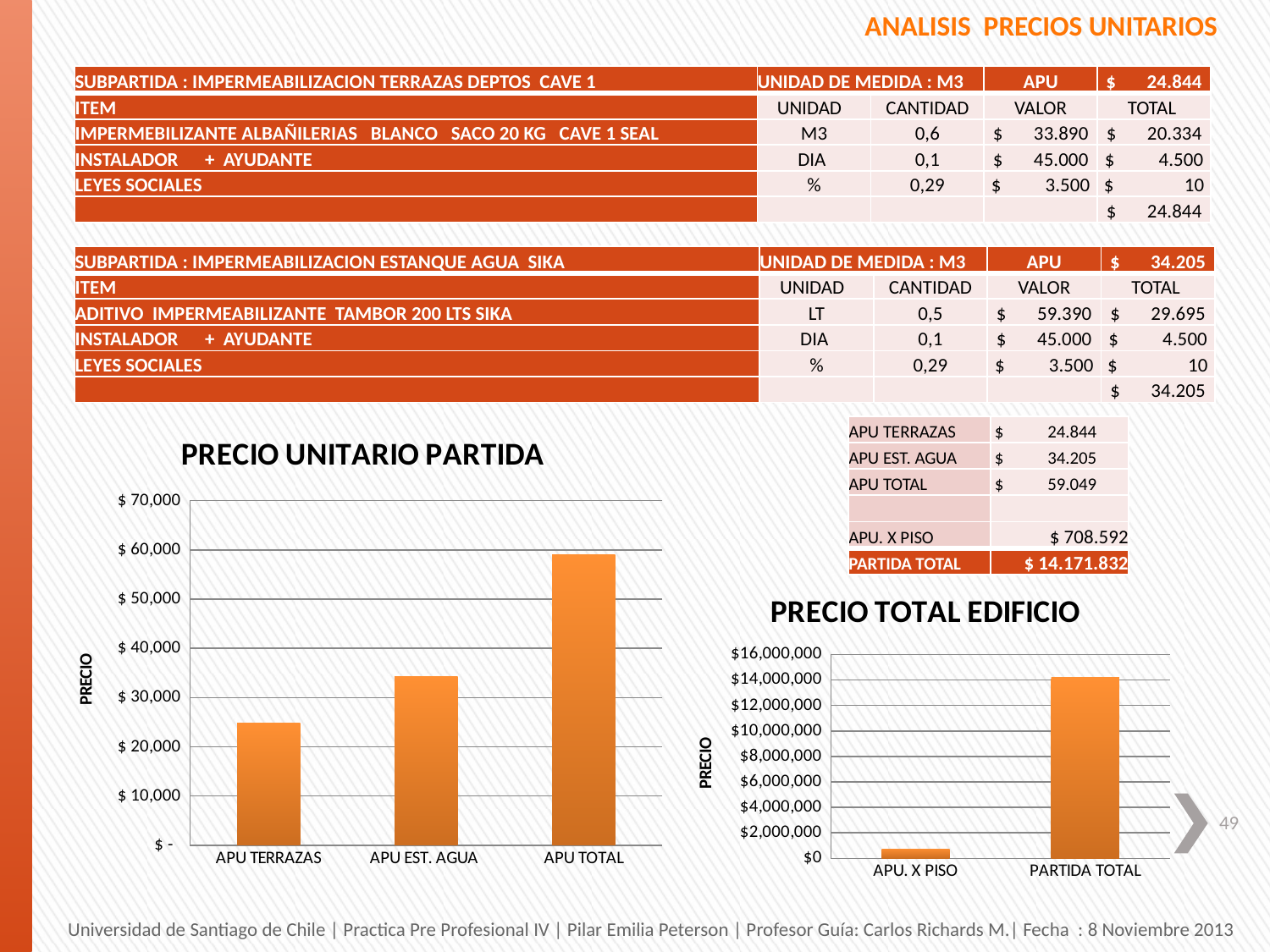
In the chart titled PRECIO TOTAL EDIFICIO, how many categories are plotted on the x axis? 2 In the chart titled PRECIO TOTAL EDIFICIO, which category has the highest bar? PARTIDA TOTAL In the chart titled PRECIO UNITARIO PARTIDA, is the value for APU TERRAZAS greater or less than $ 30,000? less In the chart titled PRECIO UNITARIO PARTIDA, how many categories are plotted on the x axis? 3 In the chart titled PRECIO UNITARIO PARTIDA, is the value for APU EST. AGUA greater or less than $ 30,000? greater In the chart titled PRECIO UNITARIO PARTIDA, what kind of chart is shown? bar chart In the chart titled PRECIO UNITARIO PARTIDA, do the bars rise or fall from left to right along the x axis? rise In the chart titled PRECIO UNITARIO PARTIDA, which category has the lowest bar? APU TERRAZAS In the chart titled PRECIO UNITARIO PARTIDA, is the value for APU TOTAL greater or less than $ 50,000? greater In the chart titled PRECIO UNITARIO PARTIDA, which is larger, APU EST. AGUA or APU TERRAZAS? APU EST. AGUA In the chart titled PRECIO UNITARIO PARTIDA, which category has the highest bar? APU TOTAL